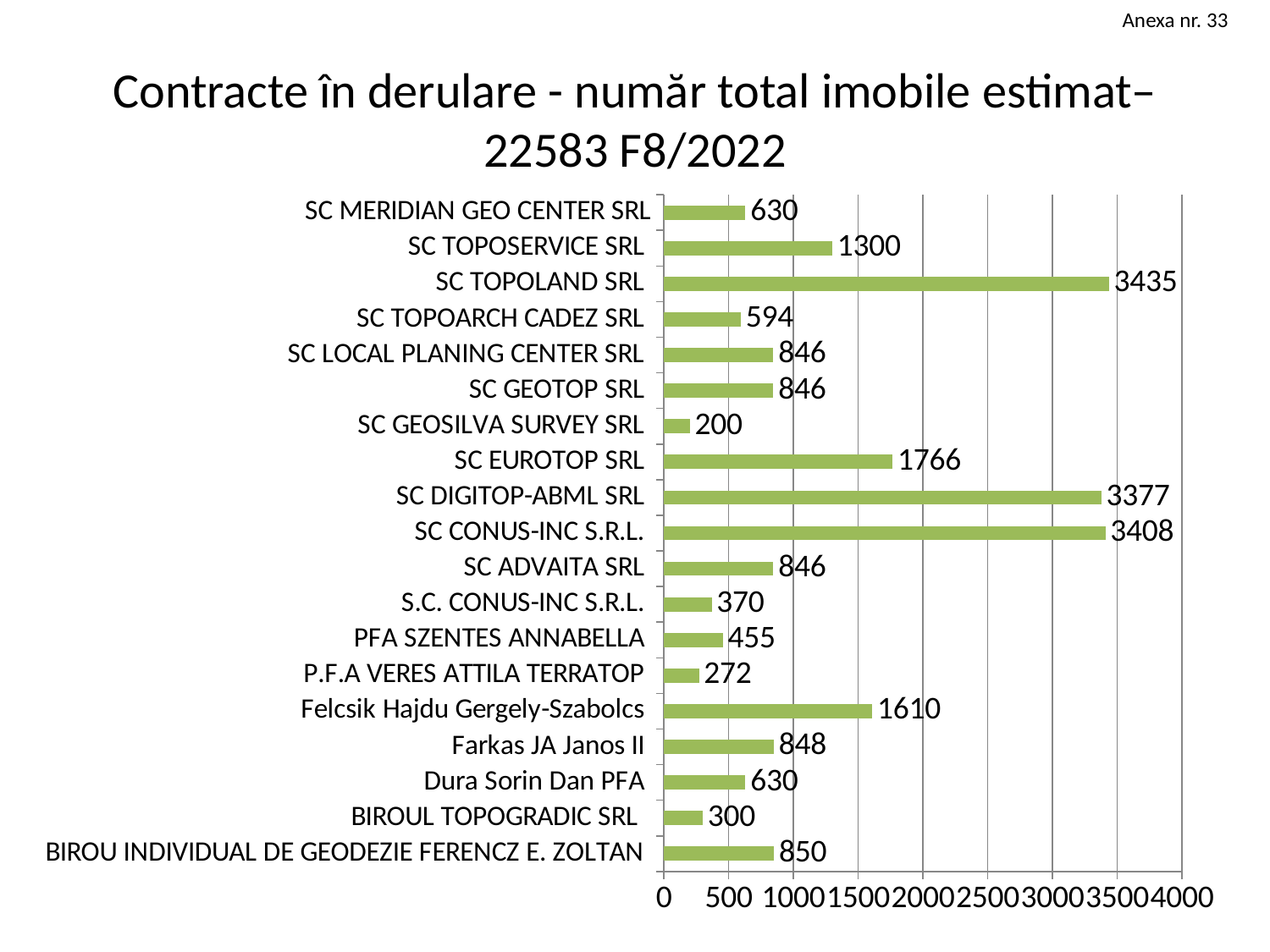
How many categories are shown in the chart? 19 What is the value for Felcsik Hajdu Gergely-Szabolcs? 1610 Which category has the highest value? SC TOPOLAND SRL What is the difference between the values for SC TOPOSERVICE SRL and SC MERIDIAN GEO CENTER SRL? 670 What is the value for SC TOPOLAND SRL? 3435 What kind of chart is shown on the slide? bar chart What is the value for SC EUROTOP SRL? 1766 What is the difference between the values for SC CONUS-INC S.R.L. and SC DIGITOP-ABML SRL? 31 Which category has the lowest value? SC GEOSILVA SURVEY SRL Is the value for SC TOPOSERVICE SRL greater or less than 1000? greater Which is larger, the value for SC EUROTOP SRL or the value for Felcsik Hajdu Gergely-Szabolcs? SC EUROTOP SRL What is the value for PFA SZENTES ANNABELLA? 455